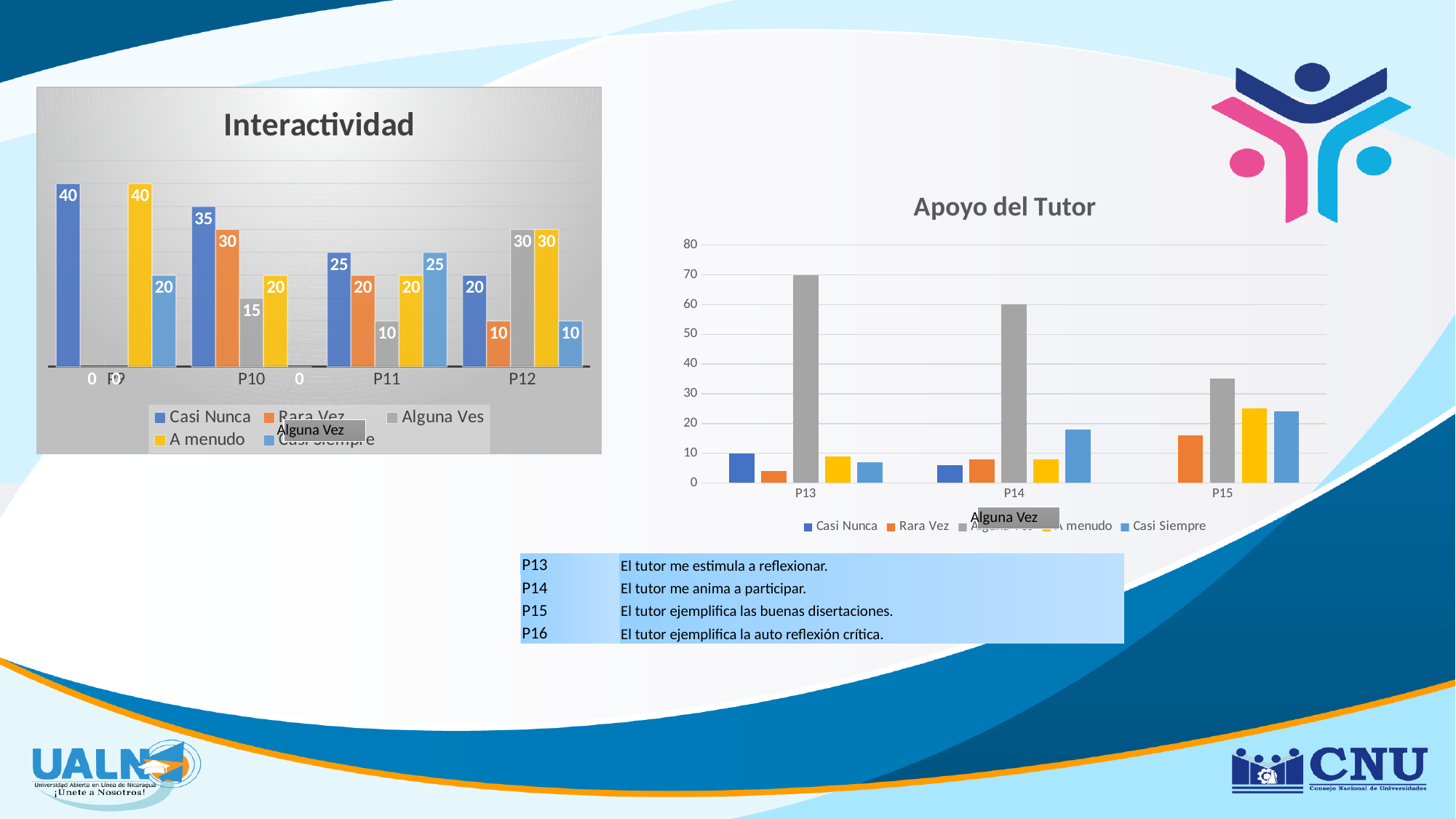
In the Interactividad chart, what is the value of Casi Nunca for P9? 40 In the Apoyo del Tutor chart, which series has the highest value for P15? Alguna Vez In the Interactividad chart, which is larger for P11: Casi Nunca or Rara Vez? Casi Nunca In the Interactividad chart, which series has the highest value for P10? Casi Nunca In the Apoyo del Tutor chart, is the value of Alguna Vez for P13 greater or less than 60? greater In the Apoyo del Tutor chart, is the value of Casi Siempre for P14 greater or less than 20? less In the Interactividad chart, how many categories are shown on the x axis? 4 What type of chart is the Apoyo del Tutor chart? bar chart In the Interactividad chart, which series has the lowest value for P11? Alguna Ves In the Interactividad chart, what is the difference between Casi Nunca and Casi Siempre for P12? 10 In the Interactividad chart, what is the value of Alguna Ves for P12? 30 In the Interactividad chart, what is the value of Rara Vez for P10? 30